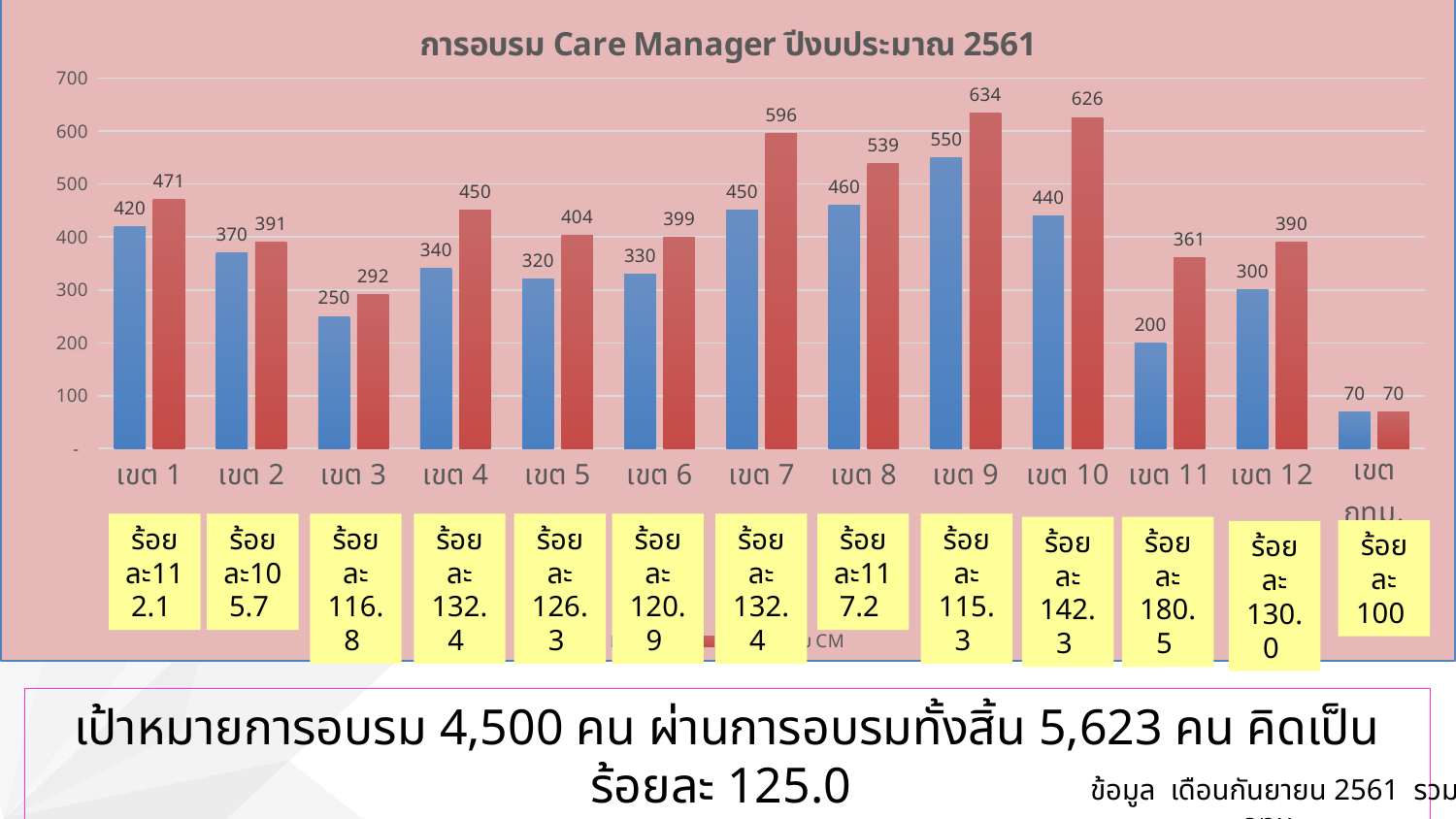
What is the title of the chart? การอบรม Care Manager ปีงบประมาณ 2561 How many categories are shown on the x axis? 13 Which category has the lowest blue bar? เขต กทม. Is the red bar for เขต 12 greater or less than 300? greater What is the value of the red bar for เขต 7? 596 What is the difference between the red bar and the blue bar for เขต 3? 42 Which is larger, the blue bar for เขต 8 or the blue bar for เขต 4? เขต 8 Which category has the highest red bar? เขต 9 What is the difference between the red bar and the blue bar for เขต 10? 186 What kind of chart is shown on the slide? bar chart What is the value of the red bar for เขต 11? 361 What is the value of the blue bar for เขต 9? 550